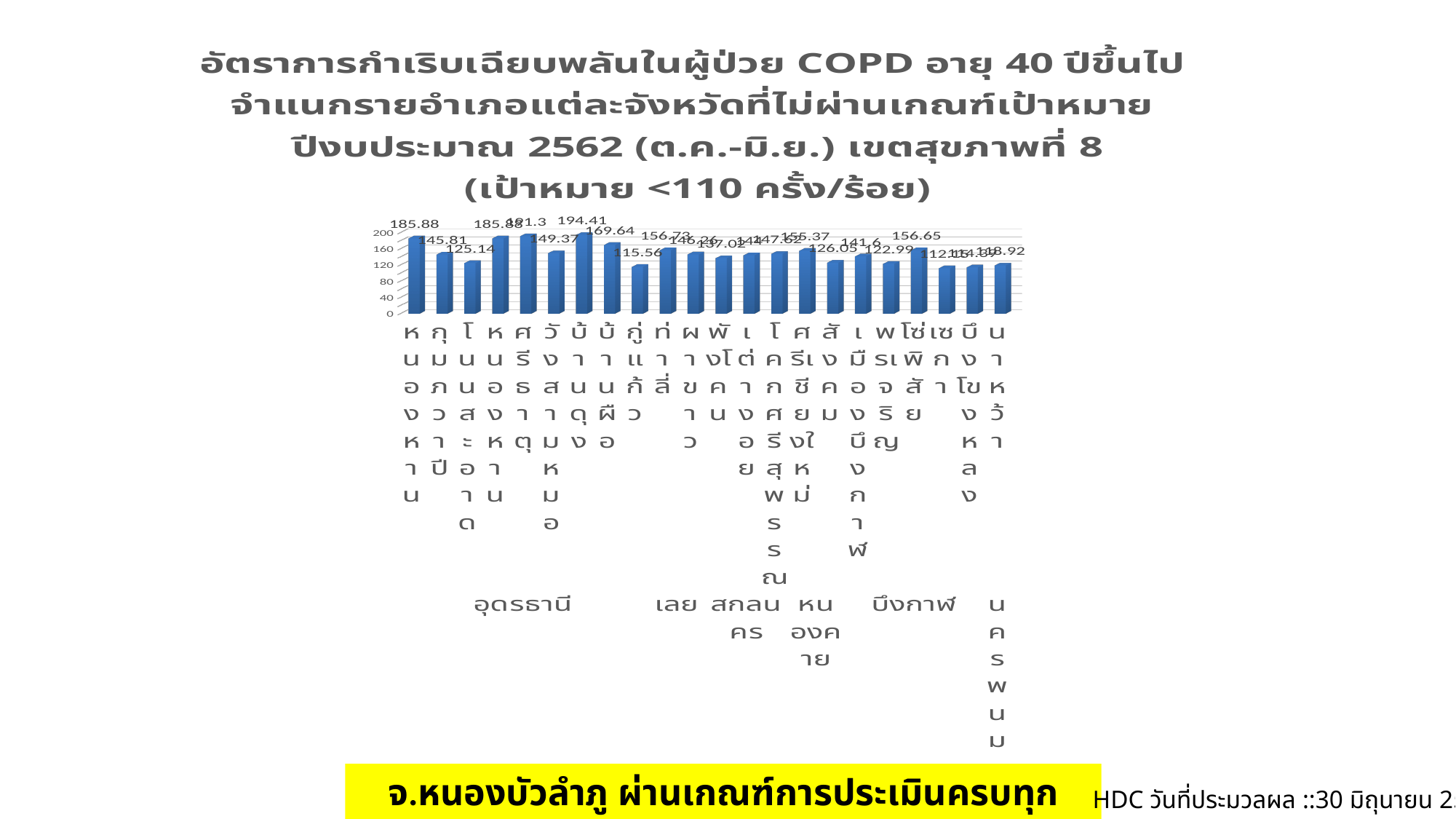
What target value is stated in the chart title? <110 ครั้ง/ร้อย Which is larger, the value for ศรีธาตุ or the value for บ้านผือ? ศรีธาตุ What is the value for โซ่พิสัย? 156.65 How many districts (bars) are plotted in the chart? 22 What is the value for บ้านดุง? 194.41 What is the value for นาหว้า? 118.92 What is the value for กู่แก้ว? 115.56 What is the difference between the values for บ้านดุง and กู่แก้ว? 78.85 What is the value for ศรีธาตุ? 191.3 Is the value for บ้านดุง greater or less than 160? greater Which district has the highest value? บ้านดุง What type of chart is shown on the slide? bar chart